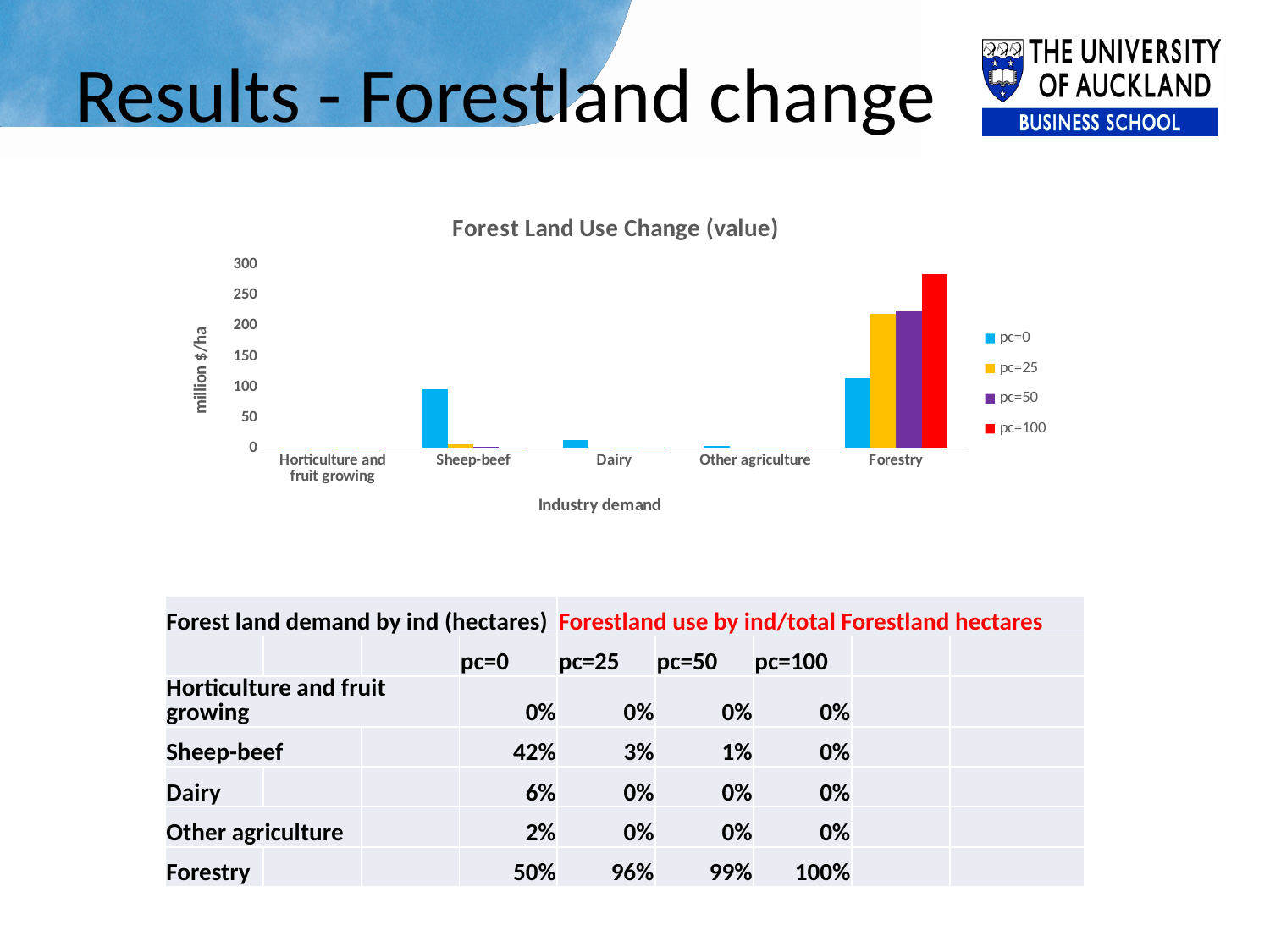
For Forestry, which is larger: the pc=100 value or the pc=0 value? pc=100 How many series does the chart's legend list? 4 Is the pc=0 value for Dairy greater or less than 50? less Which category has the highest value for the pc=0 series? Forestry Which category has the highest value for the pc=100 series? Forestry Is the pc=25 value for Forestry greater or less than 200? greater For Forestry, do the values rise or fall as pc increases from 0 to 100? rise Is the pc=0 value for Sheep-beef greater or less than 100? less What is the title of the chart? Forest Land Use Change (value) What kind of chart is shown on the slide? bar chart How many industry categories are shown on the x axis of the chart? 5